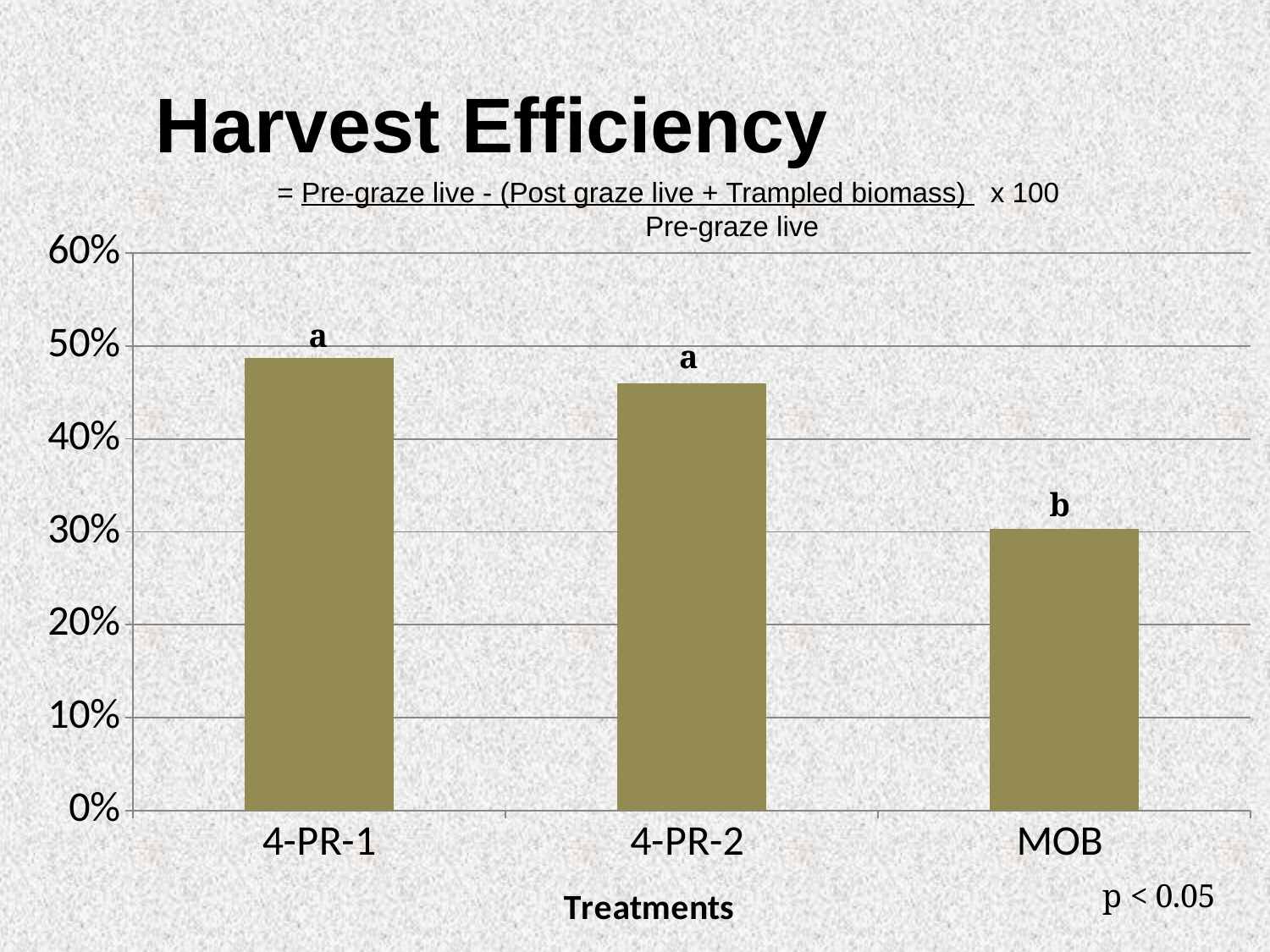
How many treatments are plotted on the x axis? 3 What significance letter is printed above the MOB bar? b Is the harvest efficiency for MOB greater or less than 20%? greater Which treatment has the lowest harvest efficiency? MOB Is the harvest efficiency for 4-PR-1 greater or less than 40%? greater Is the harvest efficiency for 4-PR-2 greater or less than 50%? less What kind of chart is shown on the slide? bar chart What is the label of the x axis? Treatments Which treatment has the highest harvest efficiency? 4-PR-1 Do the bar values rise or fall moving from 4-PR-1 to MOB along the x axis? fall Which has a higher harvest efficiency, 4-PR-2 or MOB? 4-PR-2